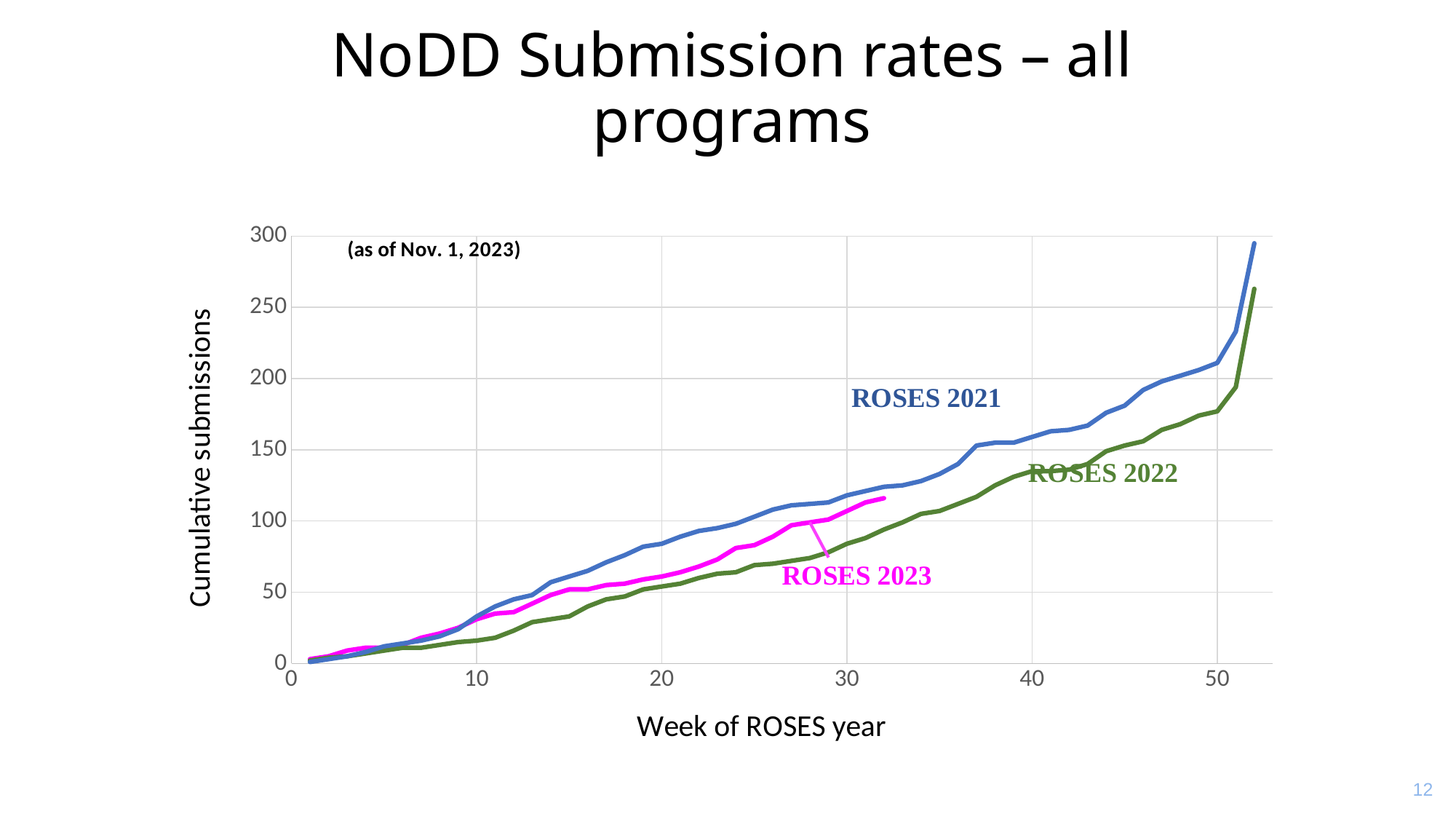
How many series are plotted on the chart? 3 Do the cumulative submissions rise or fall as the week of the ROSES year increases? rise What is the label of the y axis? Cumulative submissions Is the value for ROSES 2021 at week 40 greater or less than 200? less What date is the chart data stated to be current as of? Nov. 1, 2023 Is the value for ROSES 2022 at week 40 greater or less than 150? less Which series reaches the highest cumulative submissions at the end of the ROSES year? ROSES 2021 Is the value for ROSES 2021 at week 52 greater or less than 250? greater At week 30, which series has more cumulative submissions, ROSES 2021 or ROSES 2022? ROSES 2021 At week 50, which series has more cumulative submissions, ROSES 2021 or ROSES 2022? ROSES 2021 What kind of chart is shown on the slide? line chart